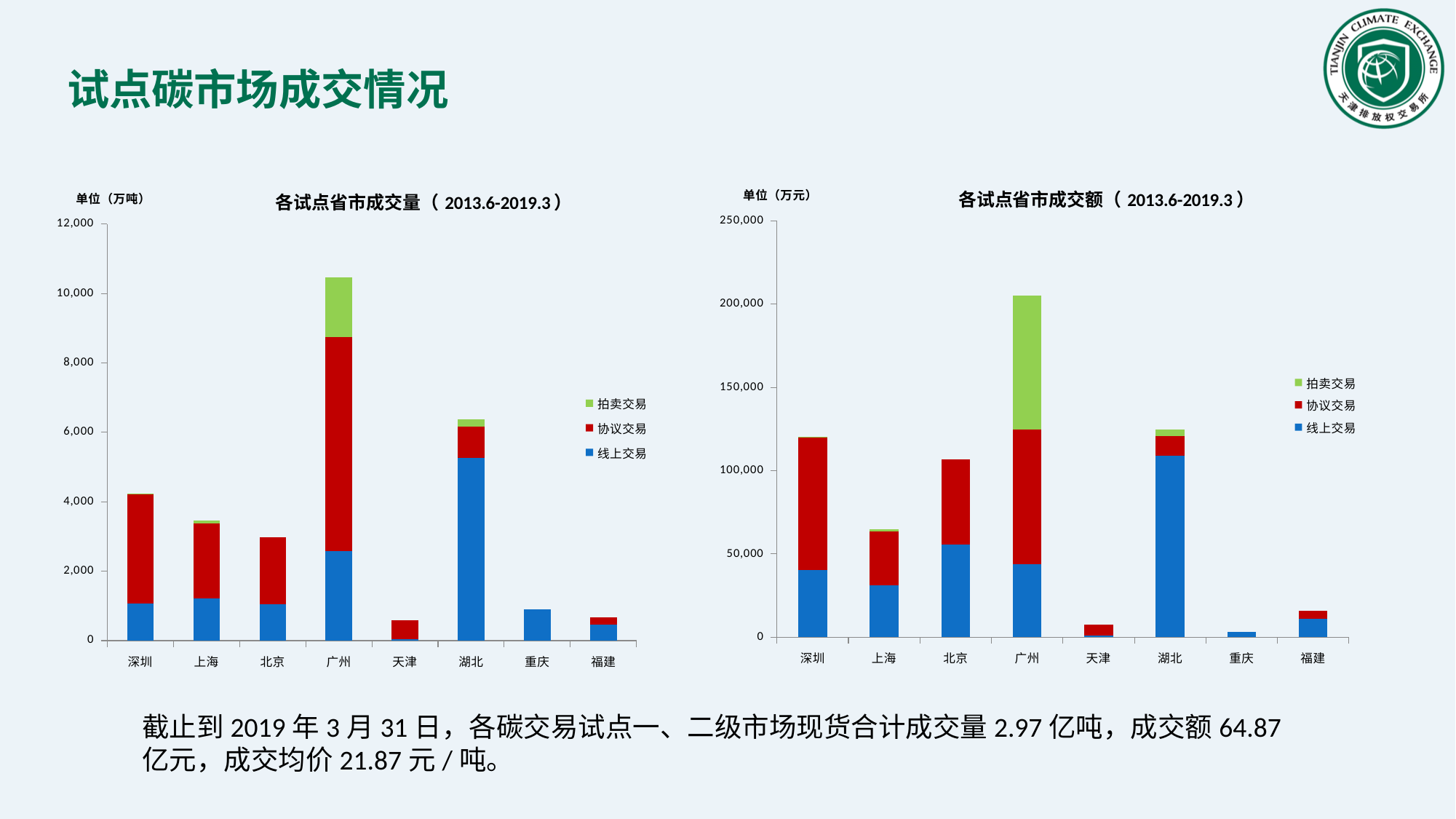
In the left chart (各试点省市成交量), how many provinces/cities are shown on the x axis? 8 What kind of chart is the left chart titled 各试点省市成交量（2013.6-2019.3）? Stacked bar chart What unit is shown for the right chart (各试点省市成交额)? 万元 In the right chart (各试点省市成交额), which has the larger total bar, 北京 or 上海? 北京 In the right chart (各试点省市成交额), is the total value for 深圳 greater or less than 100,000? greater In the left chart (各试点省市成交量), which has the larger total bar, 深圳 or 上海? 深圳 In the right chart (各试点省市成交额), which province/city has the lowest total bar? 重庆 In the left chart (各试点省市成交量), is the total value for 广州 greater or less than 10,000? greater In the left chart (各试点省市成交量), which province/city has the highest total bar? 广州 In the left chart (各试点省市成交量), is the total value for 北京 greater or less than 4,000? less In the right chart (各试点省市成交额), how many series does the legend list? 3 In the right chart (各试点省市成交额), which province/city has the highest total bar? 广州